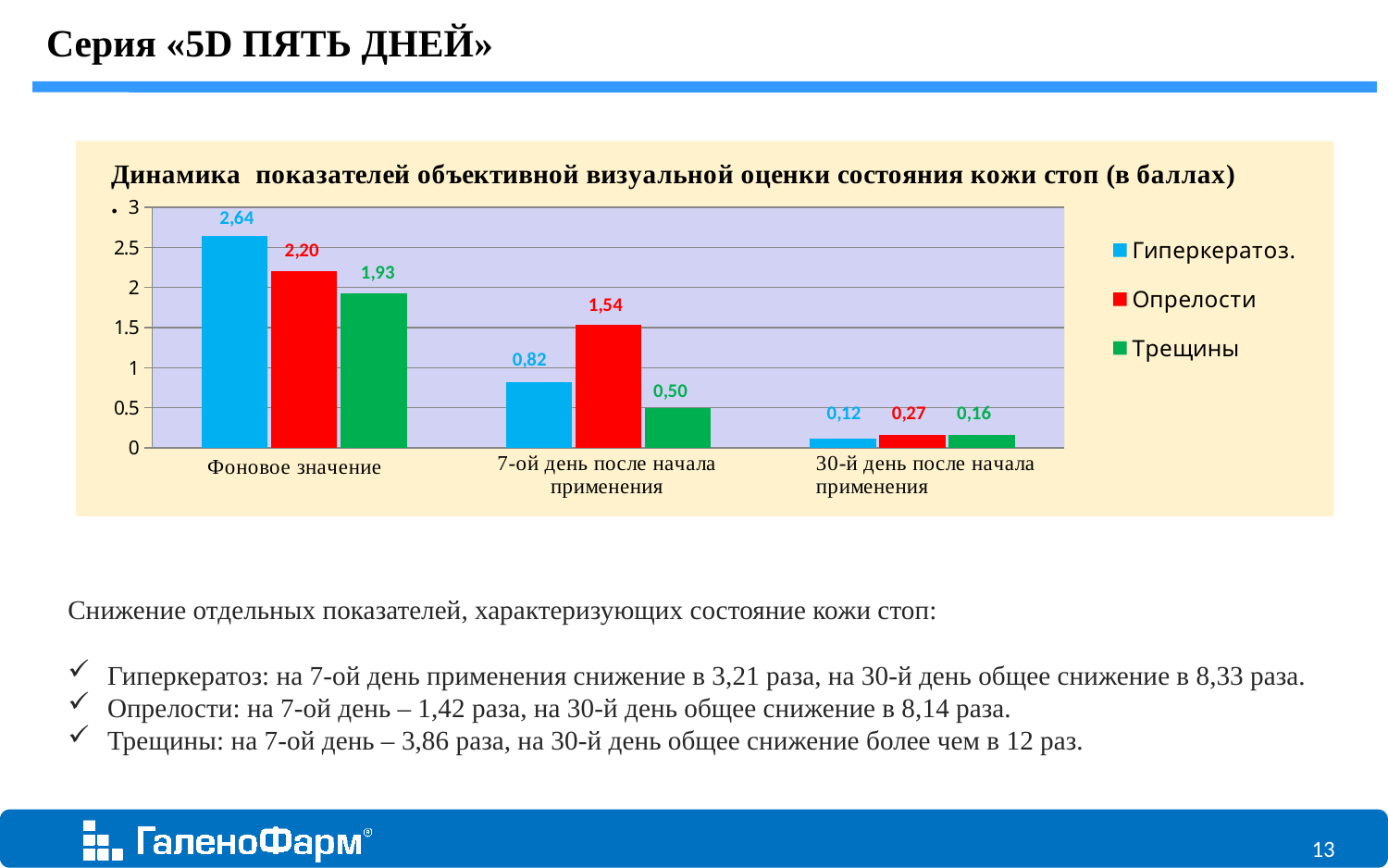
Which series has the lowest value on the 7-ой день после начала применения? Трещины What is the difference between the Гиперкератоз values at Фоновое значение and on the 7-ой день после начала применения? 1,82 Which is larger on the 30-й день после начала применения: Опрелости or Гиперкератоз? Опрелости Do the values for Опрелости rise or fall from Фоновое значение to the 30-й день после начала применения? fall How many series does the legend list? 3 What kind of chart is shown on the slide? bar chart Which series has the highest value at Фоновое значение? Гиперкератоз. What is the value for Трещины on the 30-й день после начала применения? 0,16 How many categories are shown on the x axis? 3 Is the value for Трещины at Фоновое значение greater or less than 1.5? greater What is the value for Опрелости on the 7-ой день после начала применения? 1,54 What is the value for Гиперкератоз at Фоновое значение? 2,64